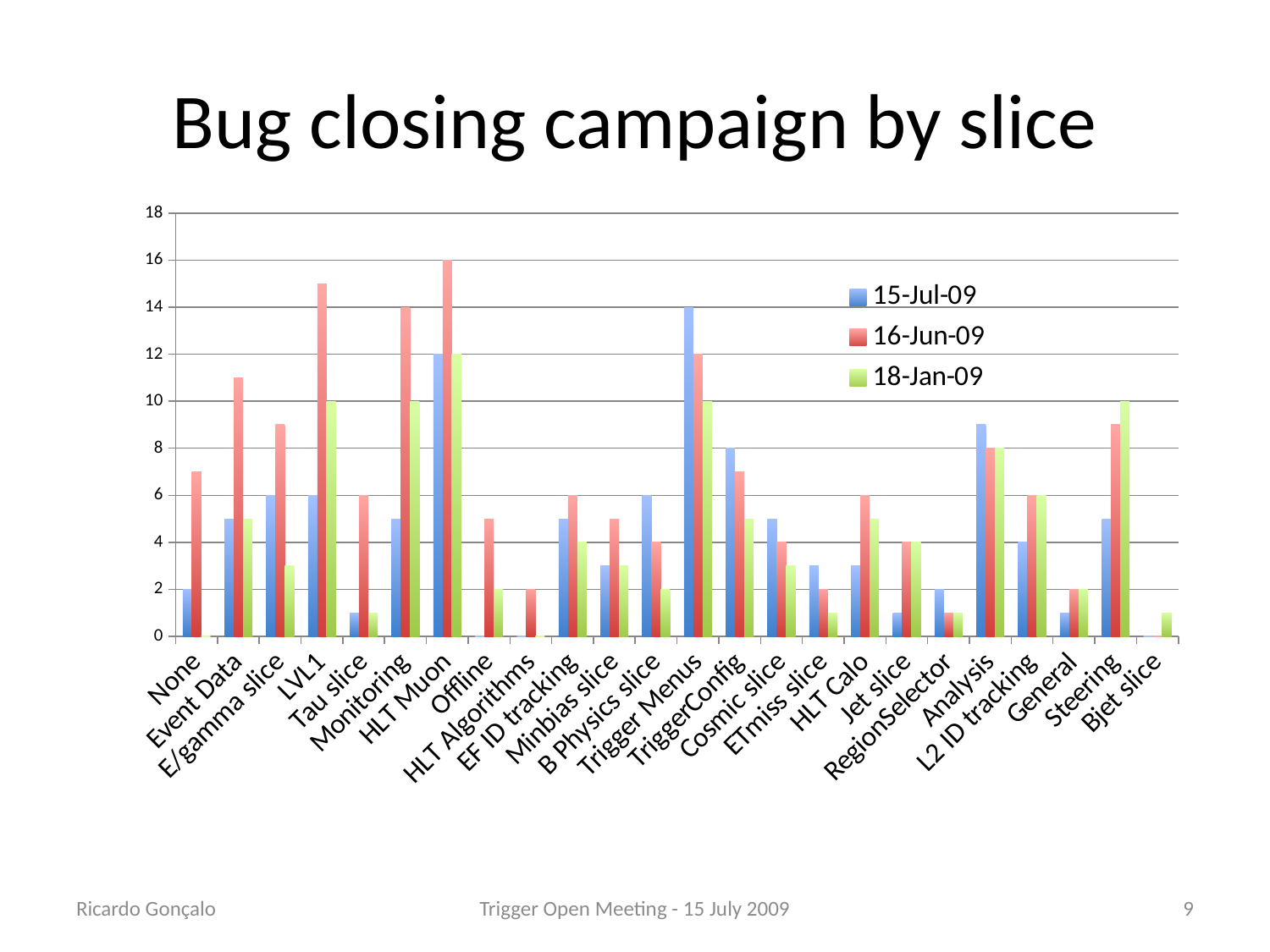
Is the 16-Jun-09 value for LVL1 greater or less than 14? greater Which category has the highest value for the 16-Jun-09 series? HLT Muon What kind of chart is shown on the slide? bar chart What is the title of the chart? Bug closing campaign by slice Which category has the highest value for the 15-Jul-09 series? Trigger Menus Is the 16-Jun-09 value for Event Data greater or less than 10? greater What is the 16-Jun-09 value for HLT Muon? 16 What is the difference between the 16-Jun-09 and 15-Jul-09 values for HLT Muon? 2 How many slice categories are shown along the x axis? 24 How many series does the legend list? 3 What is the 15-Jul-09 value for Trigger Menus? 14 For Steering, which series has the larger value, 15-Jul-09 or 18-Jan-09? 18-Jan-09